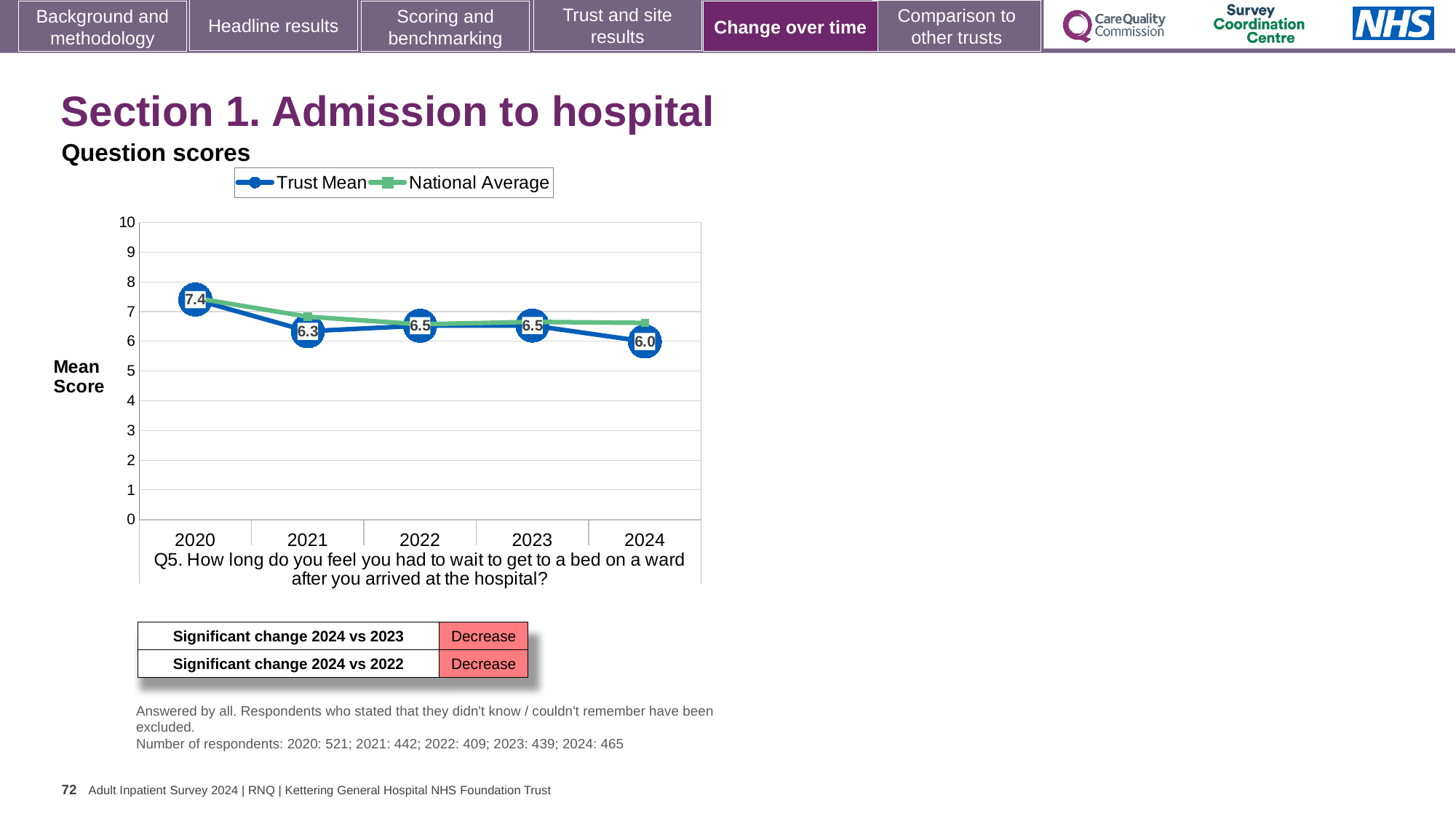
What is the Trust Mean score for 2021? 6.3 What is the Trust Mean score for 2024? 6.0 Which year has the larger Trust Mean score, 2021 or 2024? 2021 Does the Trust Mean score rise or fall overall from 2020 to 2024? fall How many years are plotted on the x axis? 5 What is the Trust Mean score for 2020? 7.4 Is the National Average value for 2020 greater or less than 7? greater How many series does the legend list? 2 In which year is the Trust Mean score lowest? 2024 What kind of chart is shown? line chart In which year is the Trust Mean score highest? 2020 What is the difference between the Trust Mean score in 2020 and in 2024? 1.4